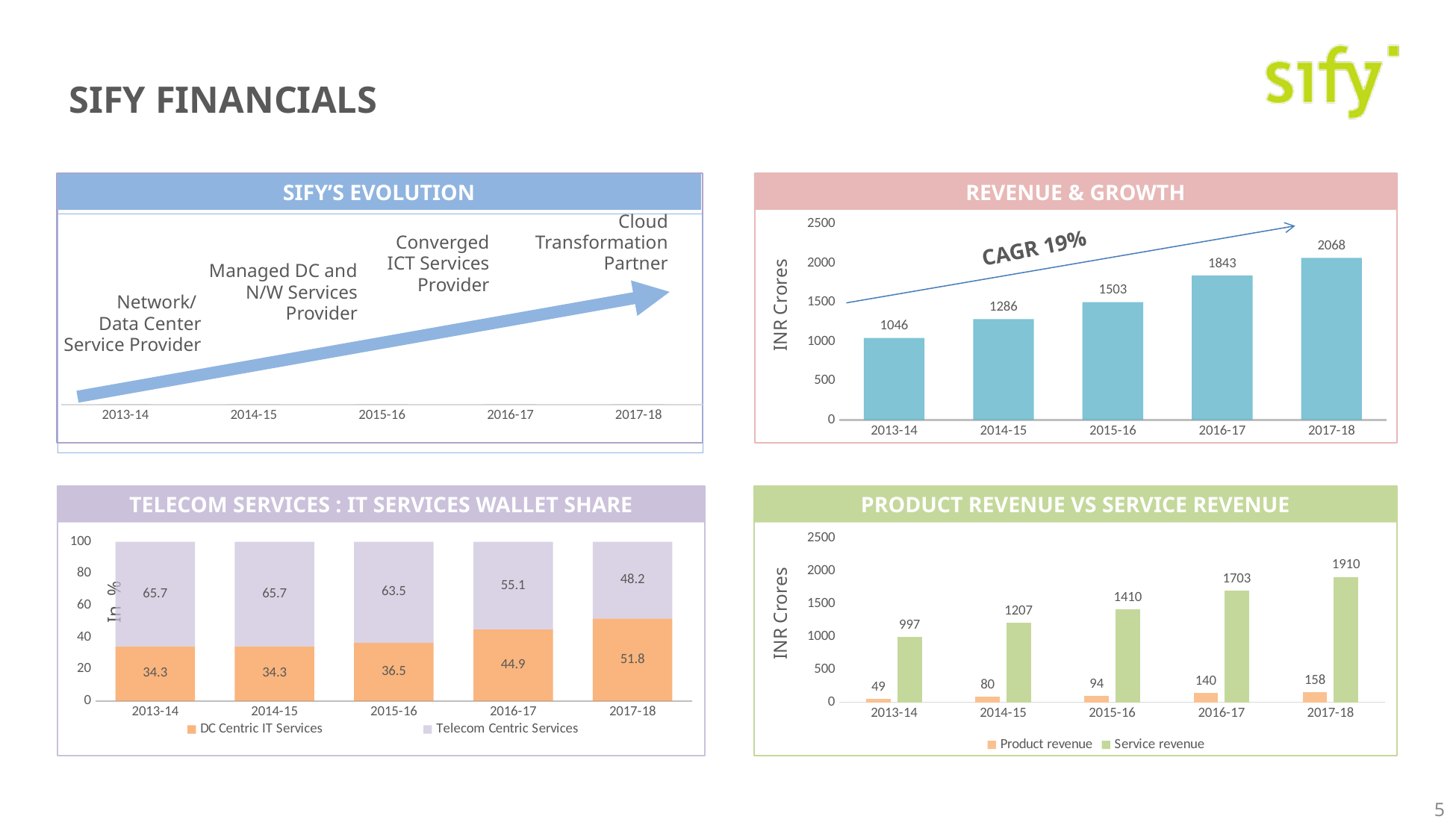
In the Product Revenue vs Service Revenue chart, what is the Service revenue for 2015-16? 1410 In the Telecom Services : IT Services Wallet Share chart, which year has the highest Telecom Centric Services share? 2013-14 and 2014-15 (65.7) In the Revenue & Growth chart, do the values rise or fall from 2013-14 to 2017-18? rise In the Telecom Services : IT Services Wallet Share chart, how many series does the legend list? 2 In the Product Revenue vs Service Revenue chart, which is larger in 2017-18: Product revenue or Service revenue? Service revenue In the Revenue & Growth chart, which year has the lowest revenue? 2013-14 In the Telecom Services : IT Services Wallet Share chart, what is the total of the stacked bar for 2017-18? 100 In the Revenue & Growth chart, what is the revenue for 2017-18? 2068 What type of chart is the Product Revenue vs Service Revenue chart? bar chart In the Revenue & Growth chart, what CAGR is shown? CAGR 19% In the Telecom Services : IT Services Wallet Share chart, what is the value for DC Centric IT Services in 2016-17? 44.9 In the Revenue & Growth chart, what is the difference in revenue between 2016-17 and 2015-16? 340